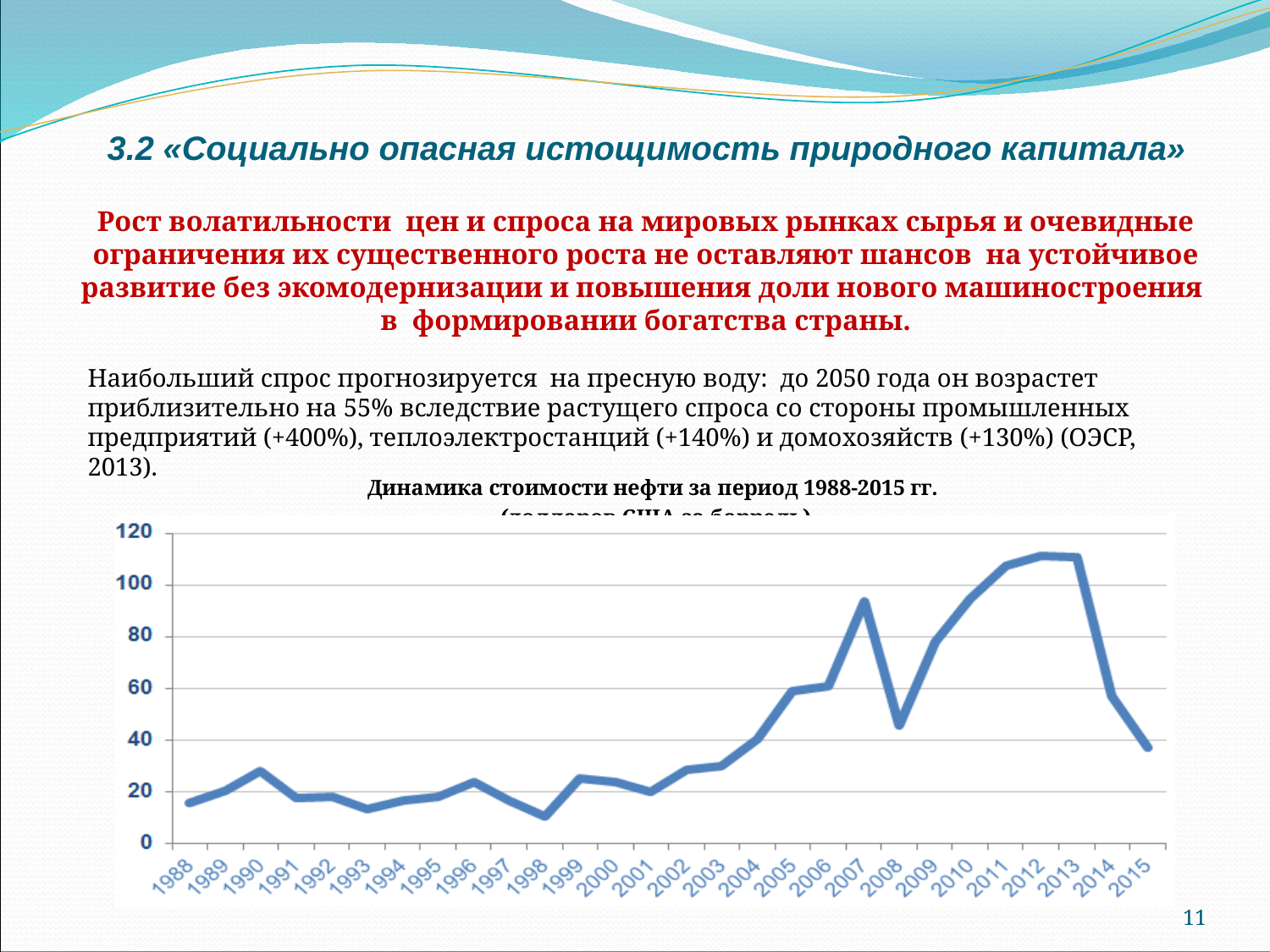
Is the value for 2007 greater or less than 80? greater Is the value for 2012 greater or less than 100? greater What is the highest value shown on the y axis of the chart? 120 How many years are plotted along the x axis of the chart? 28 Which year has the larger value, 2011 or 2015? 2011 Is the value for 2008 greater or less than 60? less Do the values rise or fall from 2013 to 2015? fall What is the title of the chart? Динамика стоимости нефти за период 1988-2015 гг. Which year has the larger value, 2007 or 2008? 2007 What kind of chart is shown on the slide? line chart